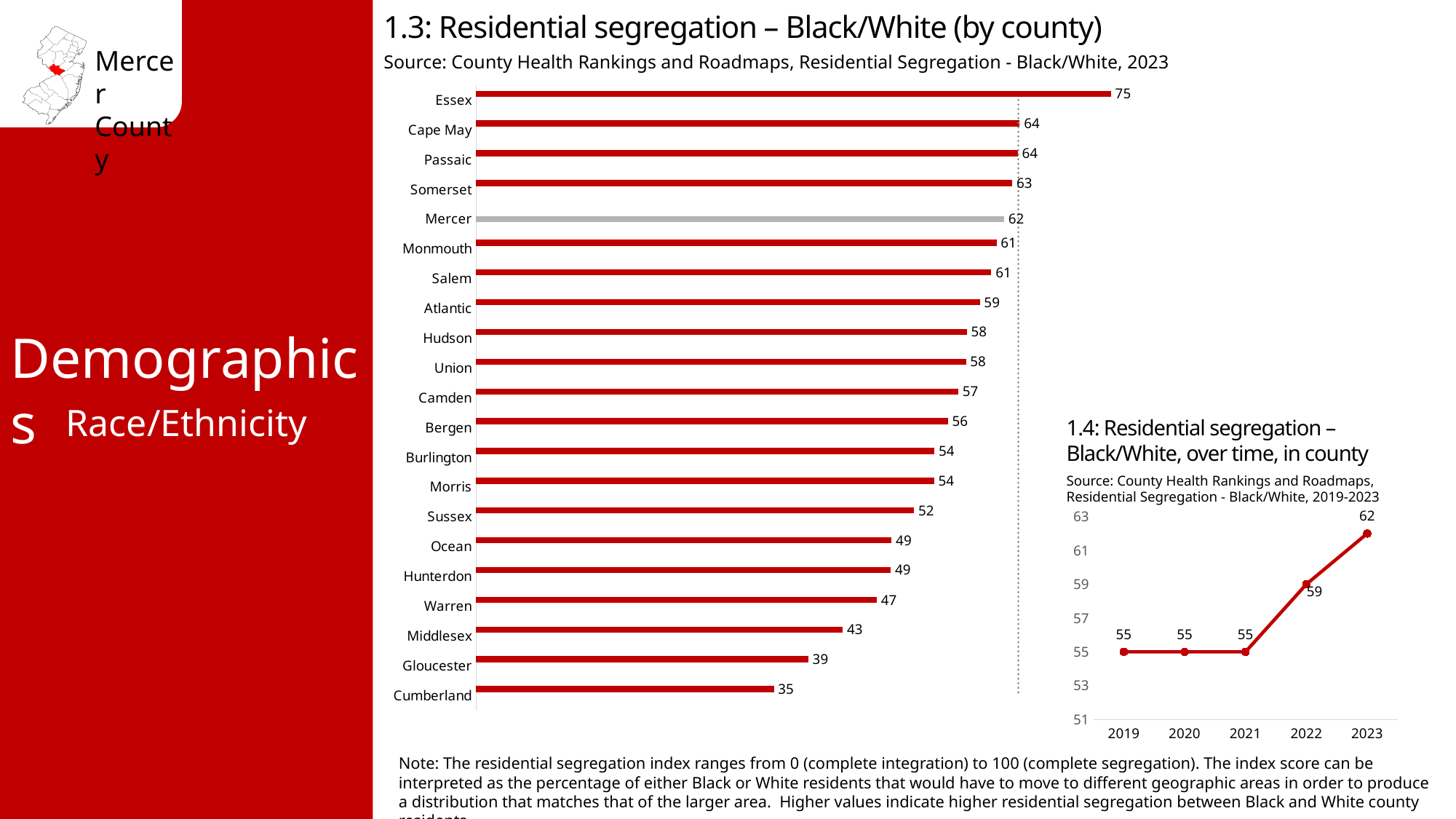
In chart 1.3 (Residential segregation – Black/White by county), what is the value for Mercer? 62 In chart 1.3 (by county), what is the value for Hunterdon? 49 In chart 1.3 (by county), which has a higher value, Middlesex or Gloucester? Middlesex In chart 1.4 (over time, in county), how many years are plotted? 5 In chart 1.4 (over time, in county), do the values rise or fall from 2021 to 2023? Rise In chart 1.4 (over time, in county), what is the difference between the 2023 and 2019 values? 7 In chart 1.3 (by county), what is the difference between the values for Essex and Cumberland? 40 In chart 1.3 (by county), how many counties are shown? 21 What kind of chart is chart 1.3 (Residential segregation – Black/White by county)? Bar chart In chart 1.3 (by county), which county has the highest residential segregation index? Essex In chart 1.4 (Residential segregation over time, in county), what is the value for 2022? 59 In chart 1.3 (by county), which county has the lowest residential segregation index? Cumberland